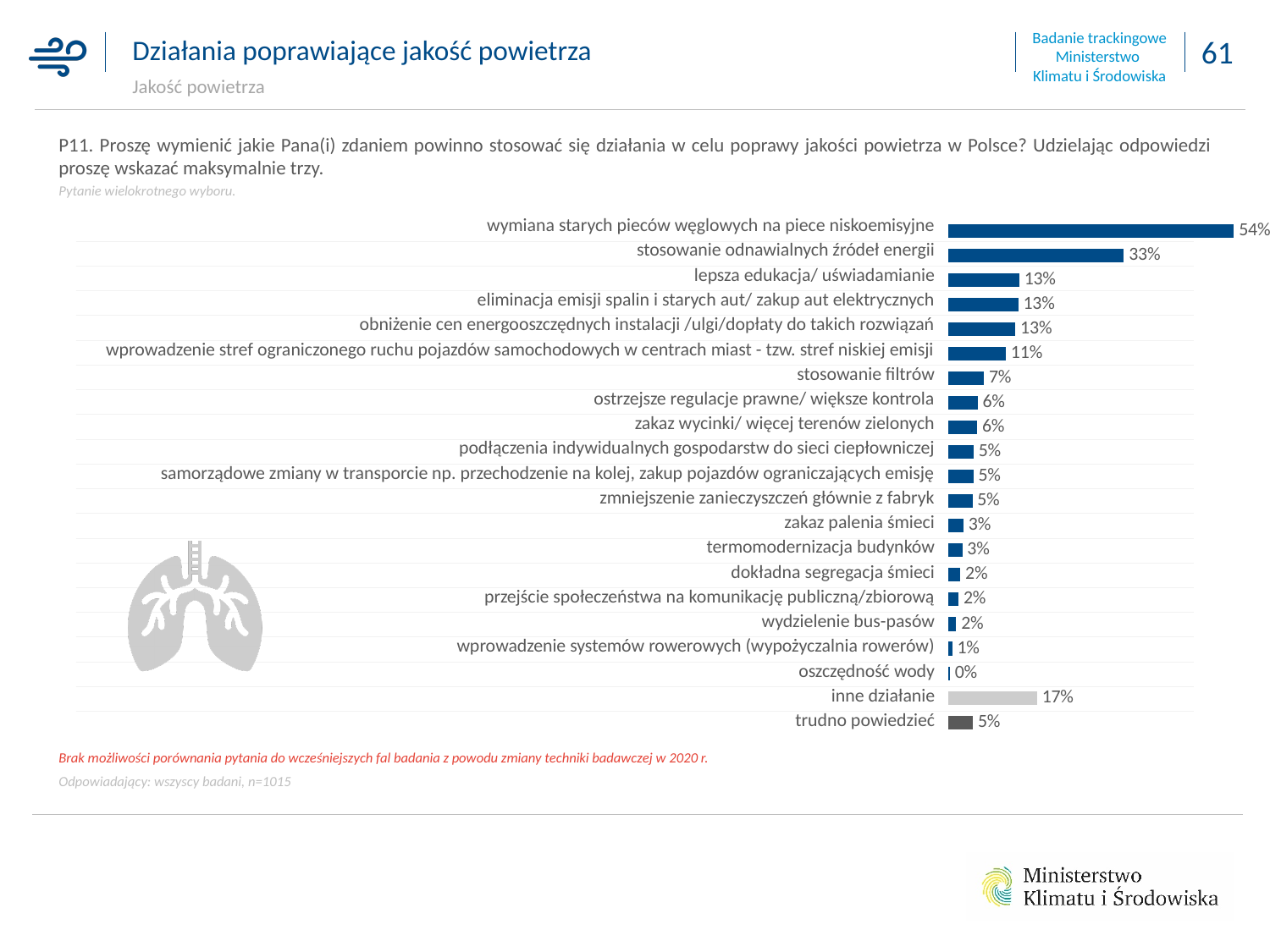
What is the value shown for 'stosowanie odnawialnych źródeł energii'? 33% Which has a larger value: 'stosowanie filtrów' or 'termomodernizacja budynków'? stosowanie filtrów What percentage is shown for 'trudno powiedzieć'? 5% What type of chart is shown on the slide? bar chart What percentage of respondents named 'wymiana starych pieców węglowych na piece niskoemisyjne'? 54% How many categories are shown in the chart? 21 What is the value shown for 'wprowadzenie systemów rowerowych (wypożyczalnia rowerów)'? 1% What is the difference between the values for 'stosowanie filtrów' and 'zakaz palenia śmieci'? 4 percentage points What value is shown for 'inne działanie'? 17% Which category has the lowest value in the chart? oszczędność wody Which category has the highest value in the chart? wymiana starych pieców węglowych na piece niskoemisyjne What is the difference between the values for 'wymiana starych pieców węglowych na piece niskoemisyjne' and 'stosowanie odnawialnych źródeł energii'? 21 percentage points